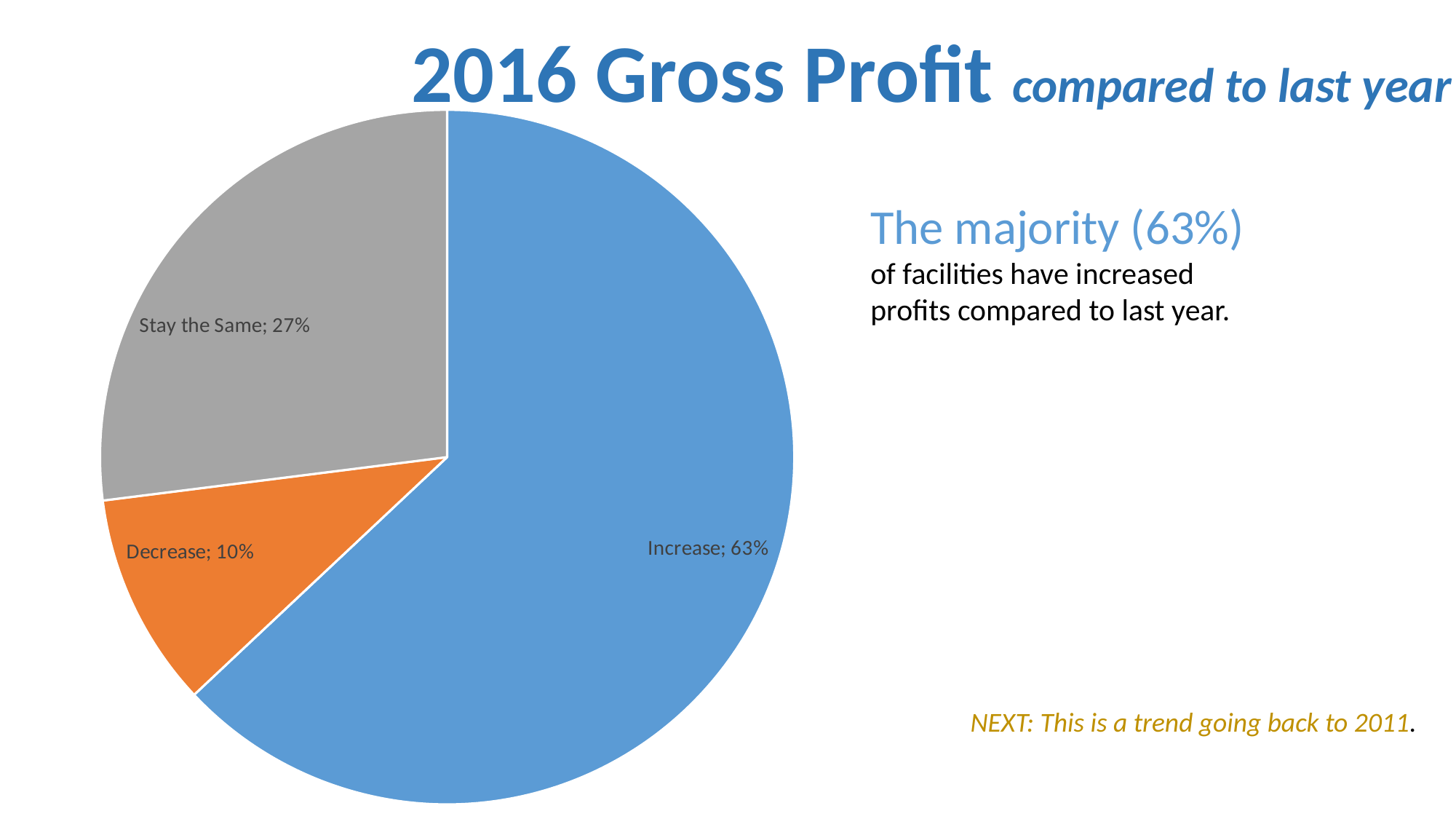
What is the difference in percentage points between the Stay the Same and Decrease slices? 17 Which category has the largest share of the pie? Increase What kind of chart is shown on the slide? Pie chart What colour is the Decrease slice? Orange What share of the pie does the Increase slice represent? 63% What percentage of facilities reported that gross profit stayed the same? 27% Which slice is larger, Stay the Same or Decrease? Stay the Same What percentage of facilities reported an increase in gross profit? 63% Which category has the smallest share of the pie? Decrease How many slices does the pie chart have? 3 What is the difference in percentage points between the Increase and Stay the Same slices? 36 What percentage of facilities reported a decrease in gross profit? 10%